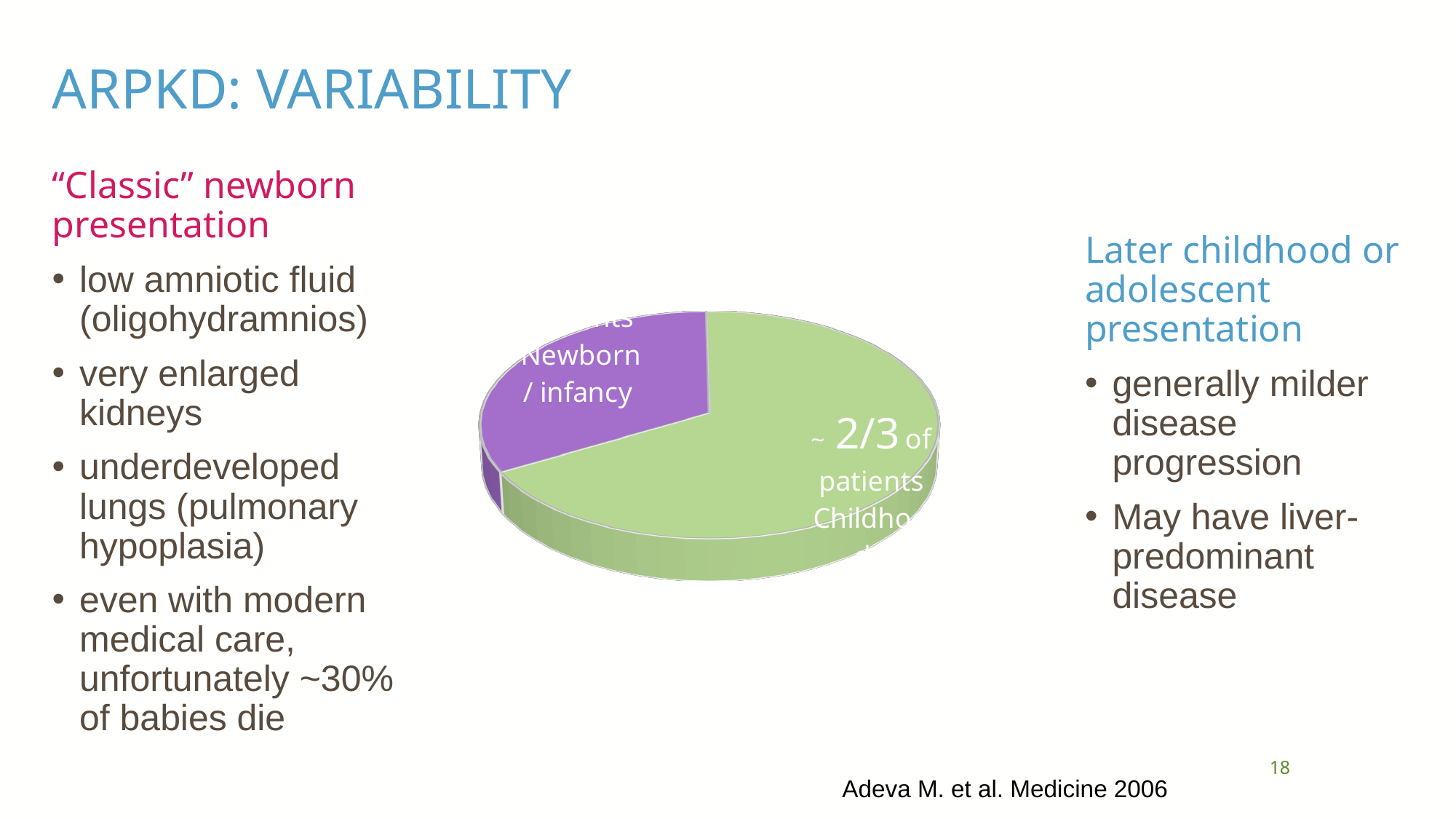
Is the green slice of the pie chart more or less than half of the pie? more What colour is the Newborn / infancy slice of the pie chart? purple Which slice of the pie chart is the smallest? Newborn / infancy How many slices does the pie chart have? 2 What colour is the slice labelled ~ 2/3 of patients? green What kind of chart is shown on the slide? pie chart Which slice of the pie chart is larger: the Newborn / infancy slice or the green slice? the green slice What share label is printed on the largest slice of the pie chart? ~ 2/3 of patients Is the Newborn / infancy slice more or less than half of the pie chart? less